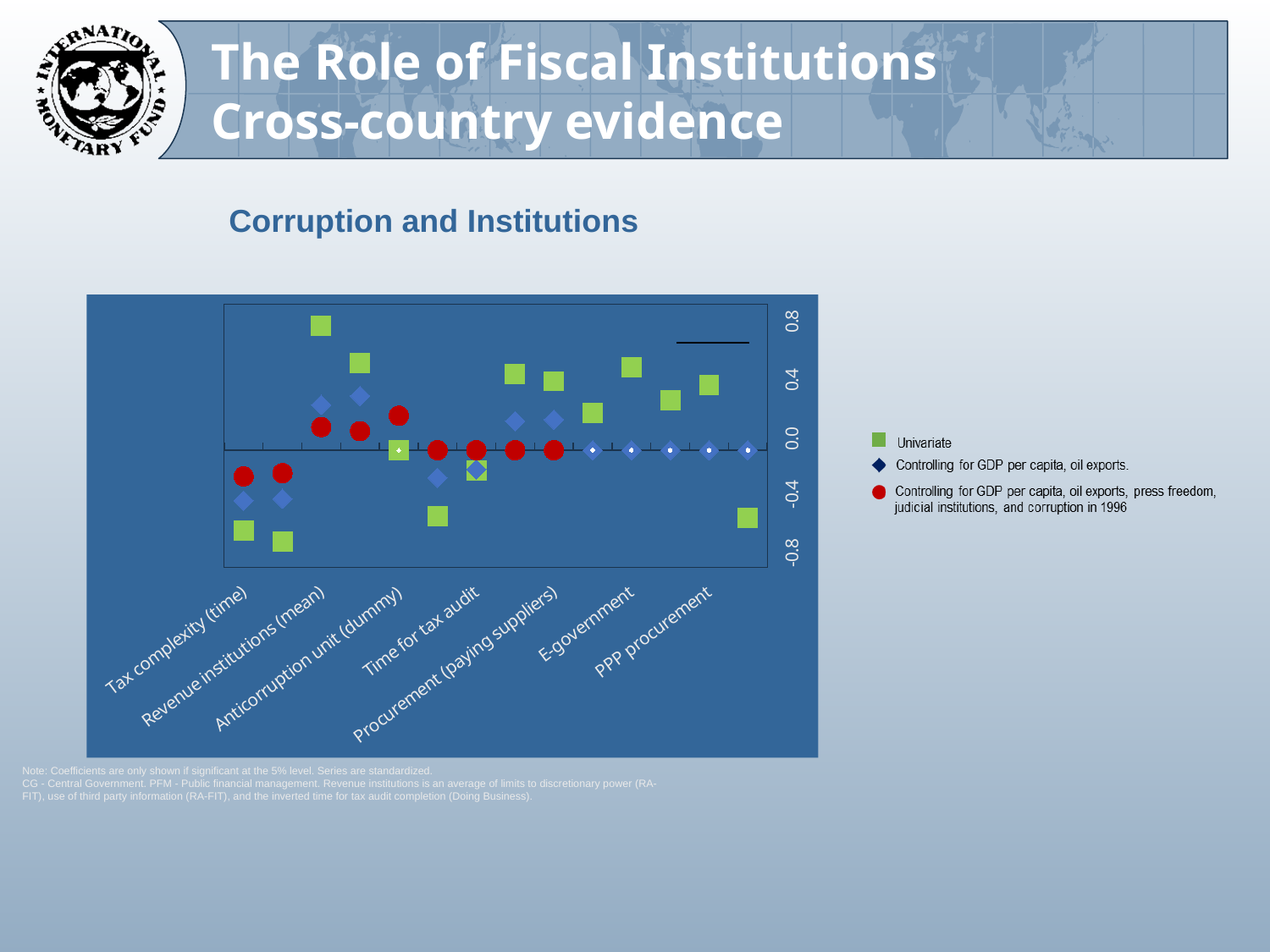
Which series has the highest plotted value on the chart? Univariate Is the lowest Univariate value on the chart greater or less than -0.4? less What is the title of the chart on the slide? Corruption and Institutions Which legend entry is represented by green squares? Univariate What is the last category label on the x axis of the chart? PPP procurement What kind of chart is shown on the slide? Scatter (dot) chart What is the first category label on the x axis of the chart? Tax complexity (time) What is the highest tick value shown on the y axis of the chart? 0.8 How many series does the chart's legend list? 3 Is the highest Univariate value on the chart greater or less than 0.4? greater How many categories are labelled along the x axis of the chart? 7 Are all the values for the series 'Controlling for GDP per capita, oil exports, press freedom, judicial institutions, and corruption in 1996' greater or less than 0.4? less